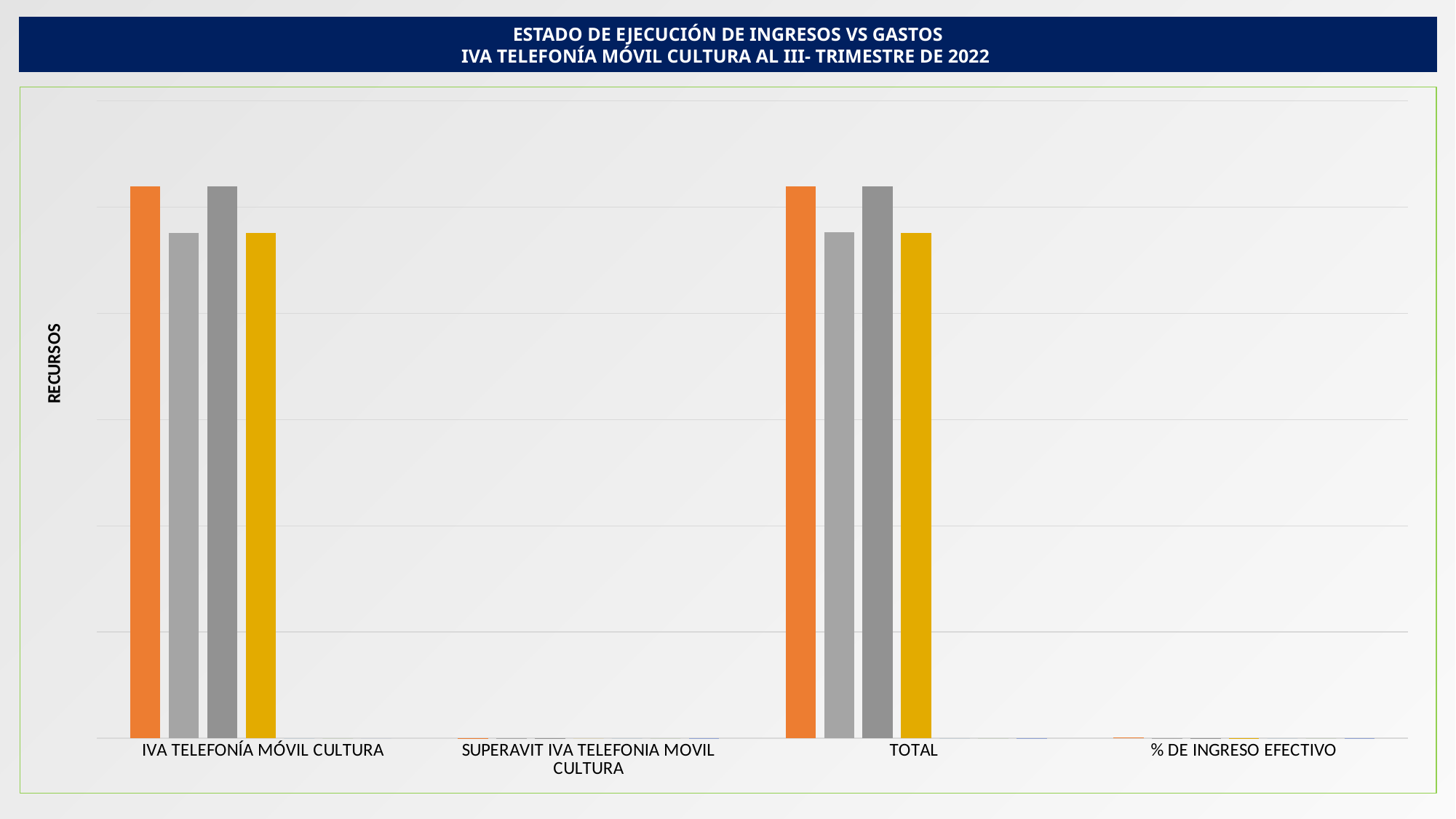
What kind of chart is shown on the slide? bar chart In the IVA TELEFONÍA MÓVIL CULTURA category, which is taller: the orange bar or the light gray bar? the orange bar How many categories are shown on the x axis of the chart? 4 In the TOTAL category, which is taller: the dark gray bar or the gold bar? the dark gray bar What is the title of the chart? ESTADO DE EJECUCIÓN DE INGRESOS VS GASTOS IVA TELEFONÍA MÓVIL CULTURA AL III- TRIMESTRE DE 2022 How many bars are visible in the IVA TELEFONÍA MÓVIL CULTURA category? 4 Which is larger: the gold bar for IVA TELEFONÍA MÓVIL CULTURA or the gold bar for % DE INGRESO EFECTIVO? IVA TELEFONÍA MÓVIL CULTURA What is the label on the vertical axis of the chart? RECURSOS